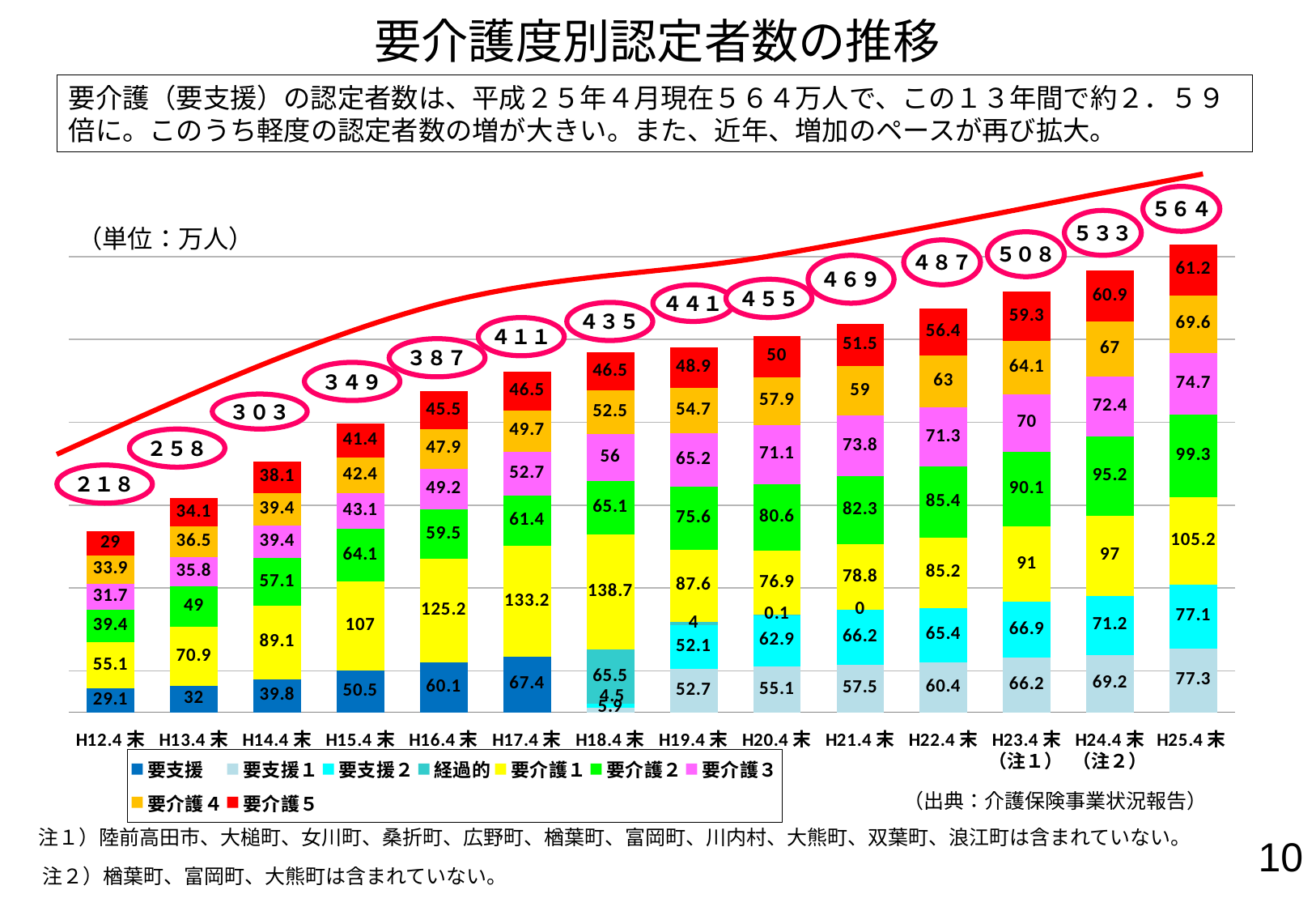
What is the value for 要介護5 at H12.4末? 29 What is the total of the stacked bar for H25.4末, as shown in the circled label? 564 What is the value for 要介護2 at H18.4末? 65.1 How many series does the legend list? 9 What is the value for 要介護1 at H25.4末? 105.2 Do the total values rise or fall from H12.4末 to H25.4末? rise Which time point has the lowest total number of certified persons? H12.4末 At H25.4末, which is larger: 要介護2 or 要介護3? 要介護2 Which time point has the highest total number of certified persons? H25.4末 How many time points (bars) are plotted along the x axis? 14 What kind of chart is shown on the slide? stacked bar chart What is the difference between the total for H25.4末 (564) and the total for H12.4末 (218)? 346